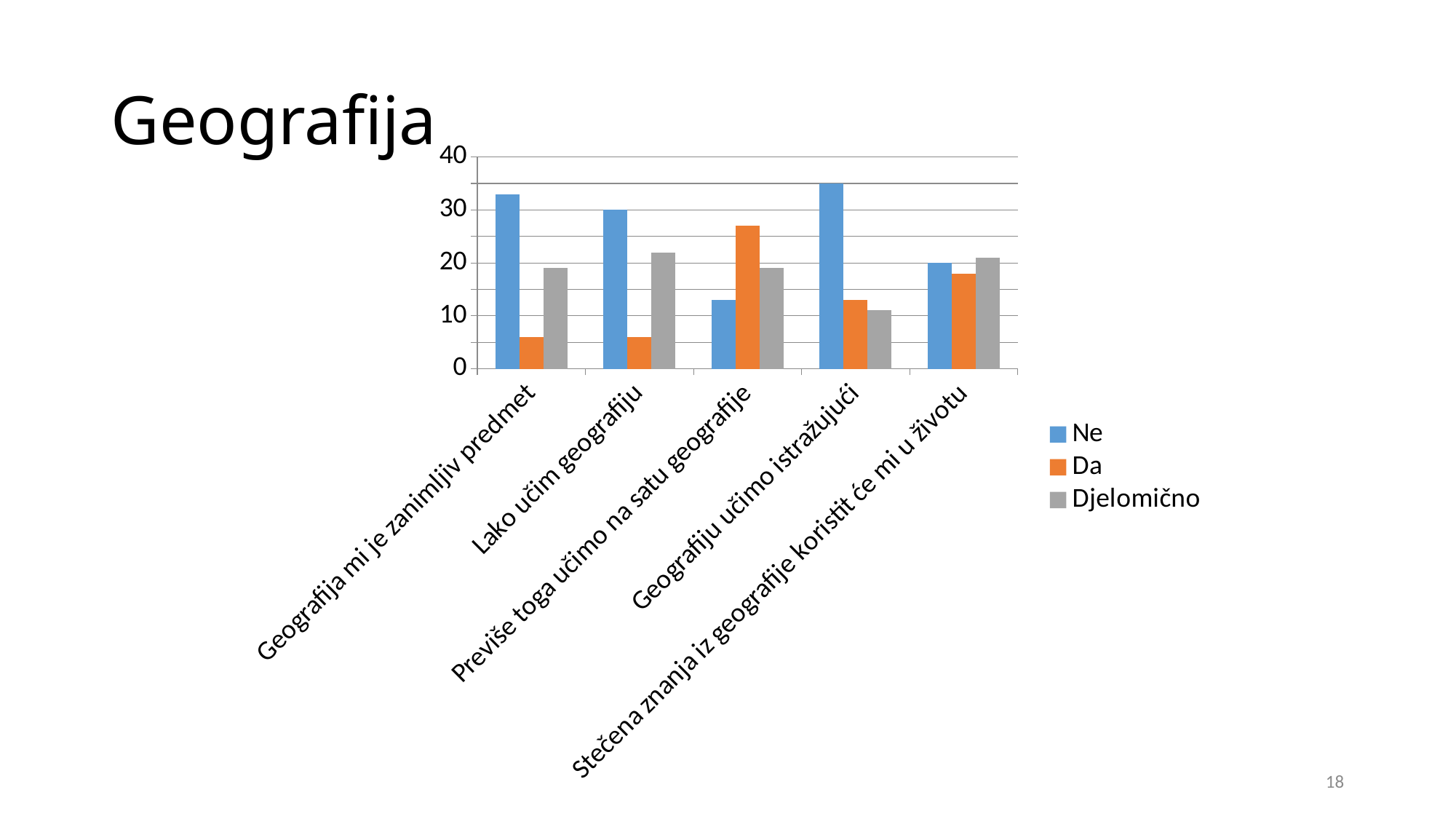
How many categories are shown on the x axis? 5 Which series has the tallest bar for 'Lako učim geografiju'? Ne What are the three entries in the chart legend? Ne, Da, Djelomično Is the 'Ne' value for 'Previše toga učimo na satu geografije' greater or less than 15? less For 'Stečena znanja iz geografije koristit će mi u životu', which is larger: 'Djelomično' or 'Da'? Djelomično Is the 'Da' value for 'Geografija mi je zanimljiv predmet' greater or less than 10? less For 'Previše toga učimo na satu geografije', which is larger: 'Da' or 'Ne'? Da Which category has the highest 'Ne' bar? Geografiju učimo istražujući How many series does the legend list? 3 What kind of chart is shown on the slide? bar chart Is the 'Djelomično' value for 'Lako učim geografiju' greater or less than 20? greater